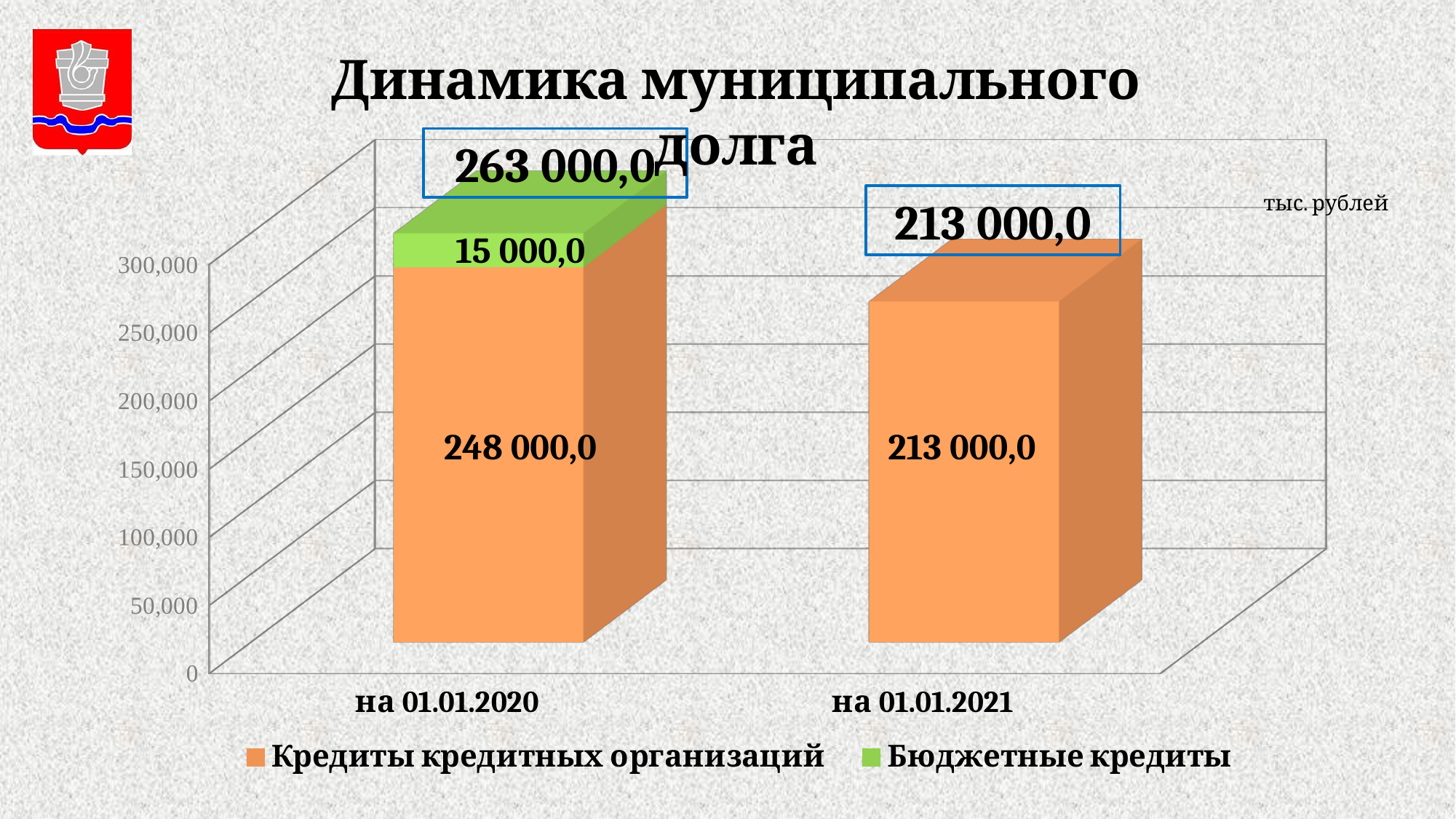
What is the value of Кредиты кредитных организаций на 01.01.2020? 248 000,0 What is the difference between Кредиты кредитных организаций на 01.01.2020 and на 01.01.2021? 35 000,0 How many series does the legend list? 2 What is the value of Бюджетные кредиты на 01.01.2020? 15 000,0 Does the total municipal debt rise or fall from 01.01.2020 to 01.01.2021? Fall What is the value of Кредиты кредитных организаций на 01.01.2021? 213 000,0 What type of chart is shown on the slide? Stacked bar chart By how much does the total debt на 01.01.2020 exceed the total на 01.01.2021? 50 000,0 What is the total municipal debt shown for на 01.01.2020? 263 000,0 What is the total municipal debt shown for на 01.01.2021? 213 000,0 Which date has the higher total municipal debt? на 01.01.2020